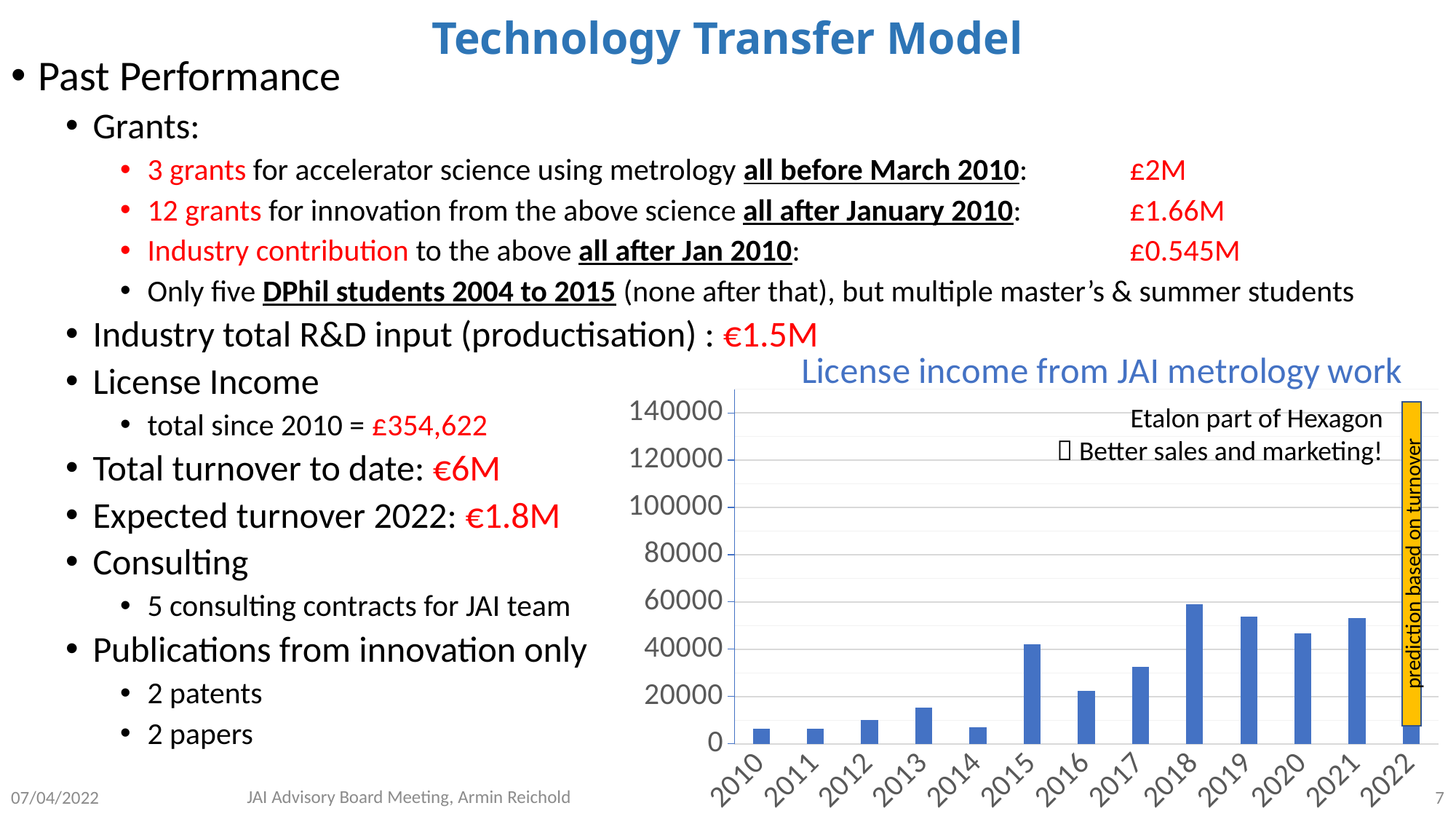
Do the values rise or fall from 2010 to 2013? rise What kind of chart is shown on the slide? bar chart Is the value for 2017 greater or less than 20000? greater Which year has the highest blue bar in the chart? 2018 Is the value for 2018 greater or less than 40000? greater Which year has the larger value, 2020 or 2021? 2021 How many years are shown on the x axis of the chart? 13 Which year has the larger value, 2015 or 2016? 2015 What is the title of the chart on the slide? License income from JAI metrology work Is the value for 2020 greater or less than 60000? less What does the label on the orange bar for 2022 say? prediction based on turnover